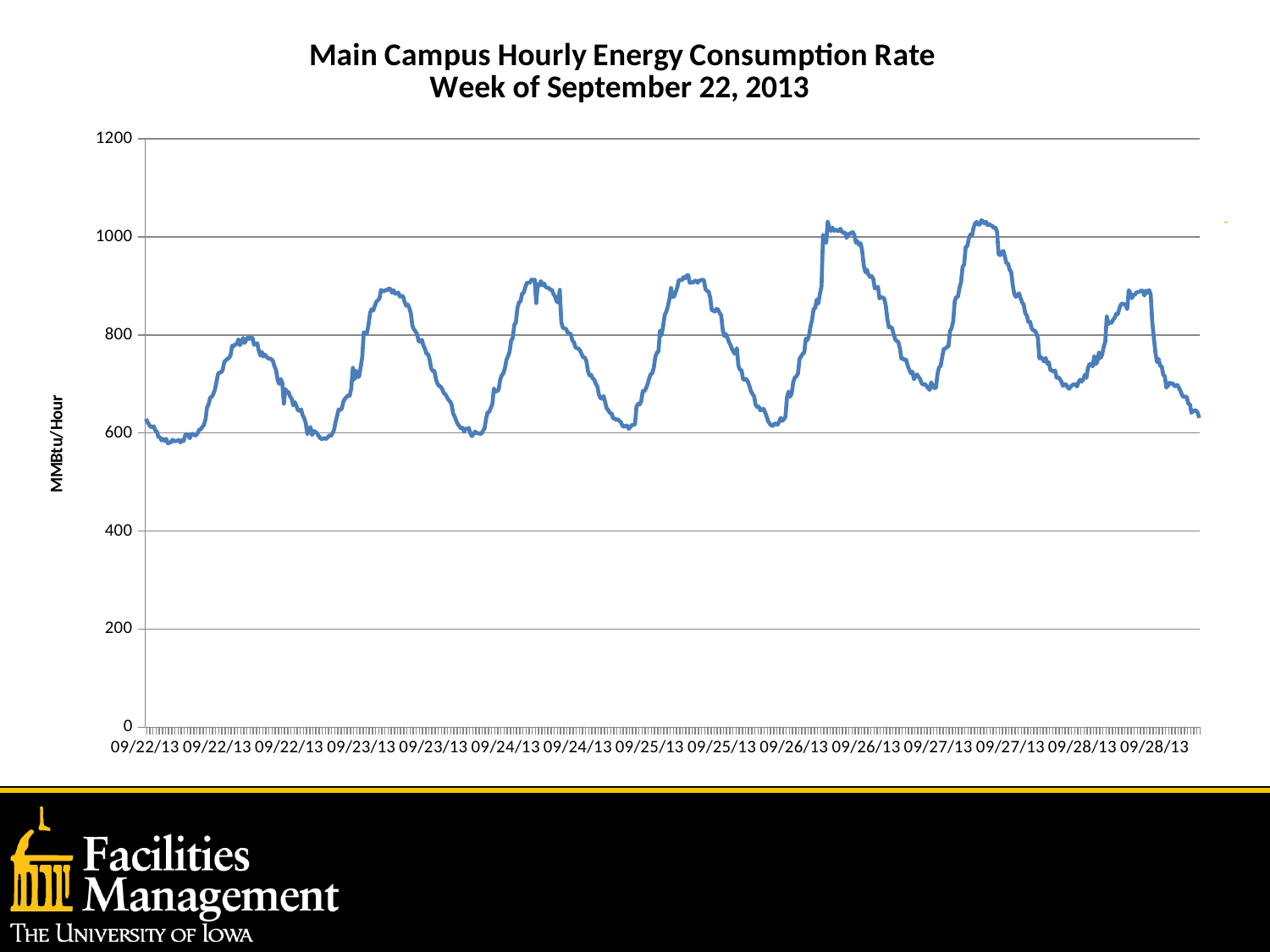
Is the peak value on 09/23/13 greater or less than 800? greater What kind of chart is shown on the slide? line chart Do the daily peaks generally rise or fall from 09/22/13 to 09/27/13? rise Does the line ever fall below 400 MMBtu/Hour during the week? No Is the peak value on 09/28/13 greater or less than 1000? less What is the highest value shown on the y-axis? 1200 What is the title of the chart? Main Campus Hourly Energy Consumption Rate Week of September 22, 2013 What unit is shown on the y-axis label? MMBtu/Hour Which day has the lowest daily peak in energy consumption? 09/22/13